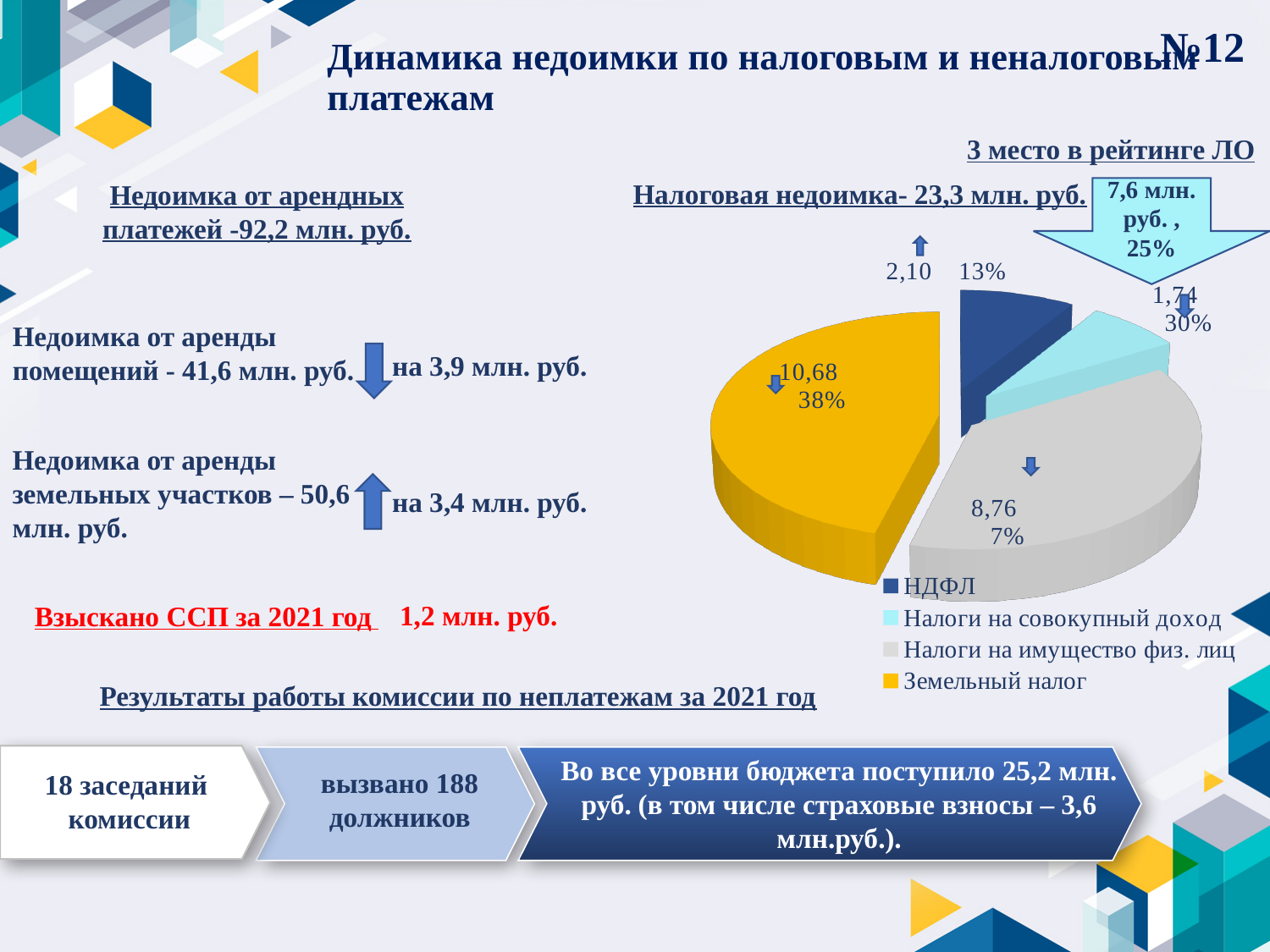
Which category has the smallest slice in the pie chart? Налоги на совокупный доход How many slices does the pie chart have? 4 What is the value shown for Налоги на имущество физ. лиц in the pie chart? 8,76 What colour is the Земельный налог slice in the pie chart? yellow How many entries does the legend of the pie chart list? 4 Which category has the largest slice in the pie chart? Земельный налог Which is larger in the pie chart: НДФЛ or Налоги на имущество физ. лиц? Налоги на имущество физ. лиц What is the value shown for Налоги на совокупный доход in the pie chart? 1,74 What is the value shown for НДФЛ in the pie chart? 2,10 What is the value shown for Земельный налог in the pie chart? 10,68 What is the difference between the values for Земельный налог and Налоги на имущество физ. лиц? 1,92 What kind of chart is shown on the slide? pie chart